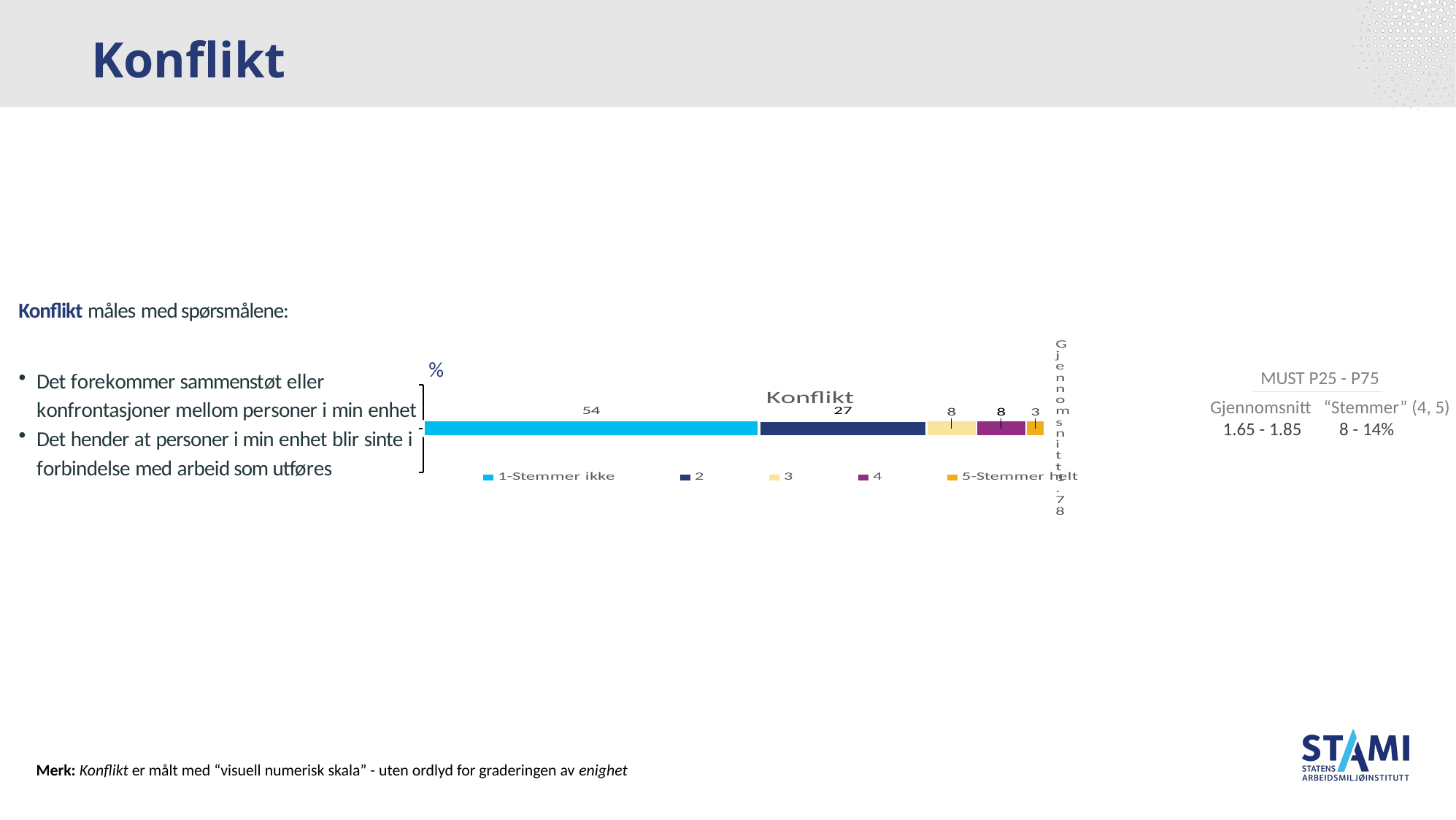
Which segment of the Konflikt bar has the lowest value? 5-Stemmer helt How many series does the legend of the Konflikt chart list? 5 Which segment of the Konflikt bar has the highest value? 1-Stemmer ikke Which is larger in the Konflikt chart, the "2" segment or the "3" segment? 2 What kind of chart is shown on the slide? bar chart What is the value for the "5-Stemmer helt" segment in the Konflikt chart? 3 What is the value for the "1-Stemmer ikke" segment in the Konflikt chart? 54 What is the difference between the "1-Stemmer ikke" and "2" segments in the Konflikt chart? 27 What colour is the "1-Stemmer ikke" segment in the Konflikt chart? light blue What is the total of all segments in the Konflikt stacked bar? 100 What is the title of the chart? Konflikt What is the value for the "2" segment in the Konflikt chart? 27